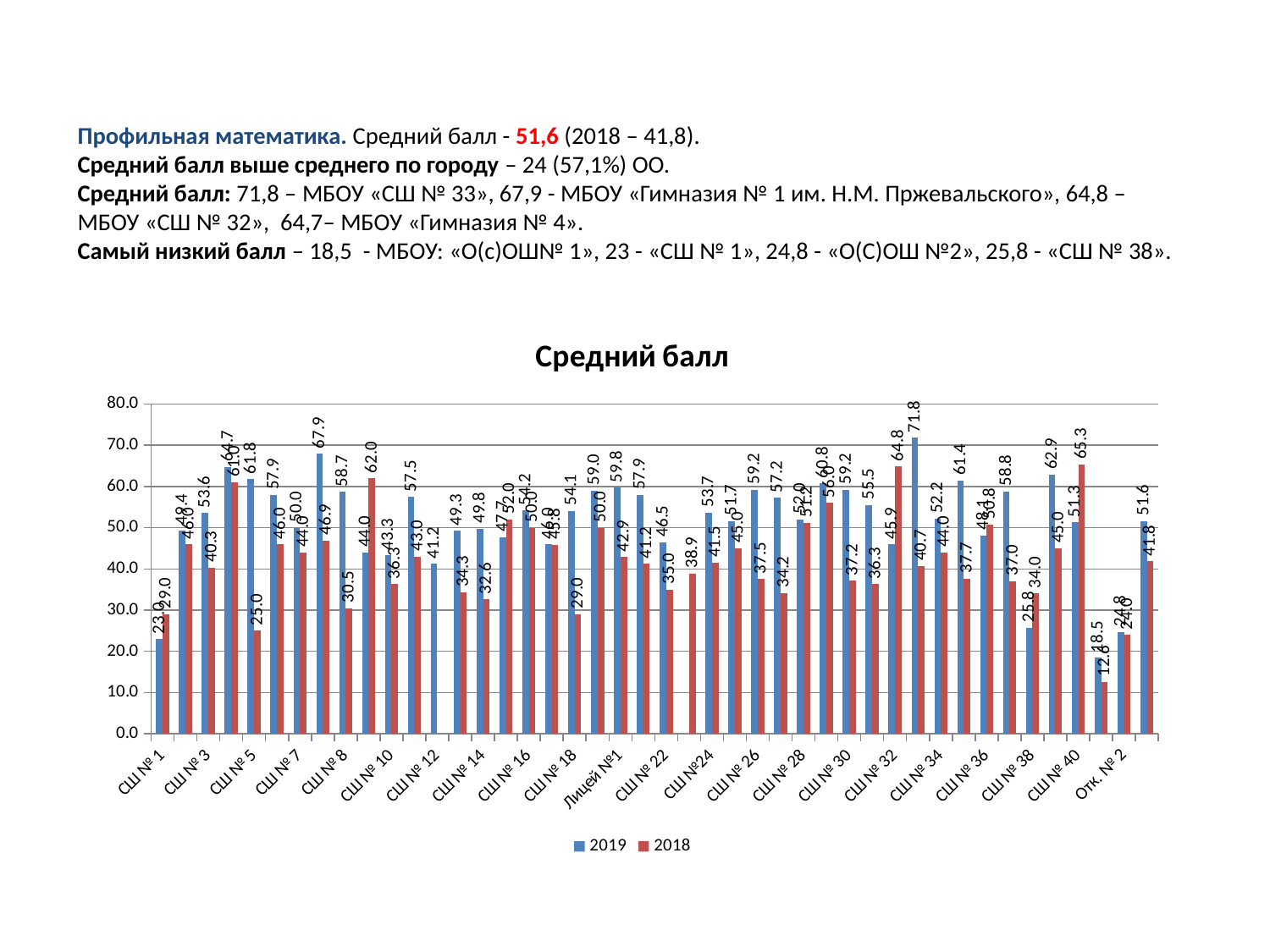
What is the lowest 2018 value shown in the chart? 12.6 What is the highest 2019 value shown in the chart? 71.8 What is the 2019 value for СШ № 38? 25.8 What is the difference between the 2018 and 2019 values for СШ № 1? 6.0 Is the 2019 value for СШ № 38 greater or less than 30.0? less What is the 2019 value for СШ № 1? 23.0 What is the 2018 value for СШ № 1? 29.0 Which two series are listed in the chart legend? 2019 and 2018 What is the title of the chart? Средний балл What kind of chart is shown on the slide? bar chart How many series does the chart legend list? 2 For СШ № 1, which year has the larger value, 2019 or 2018? 2018